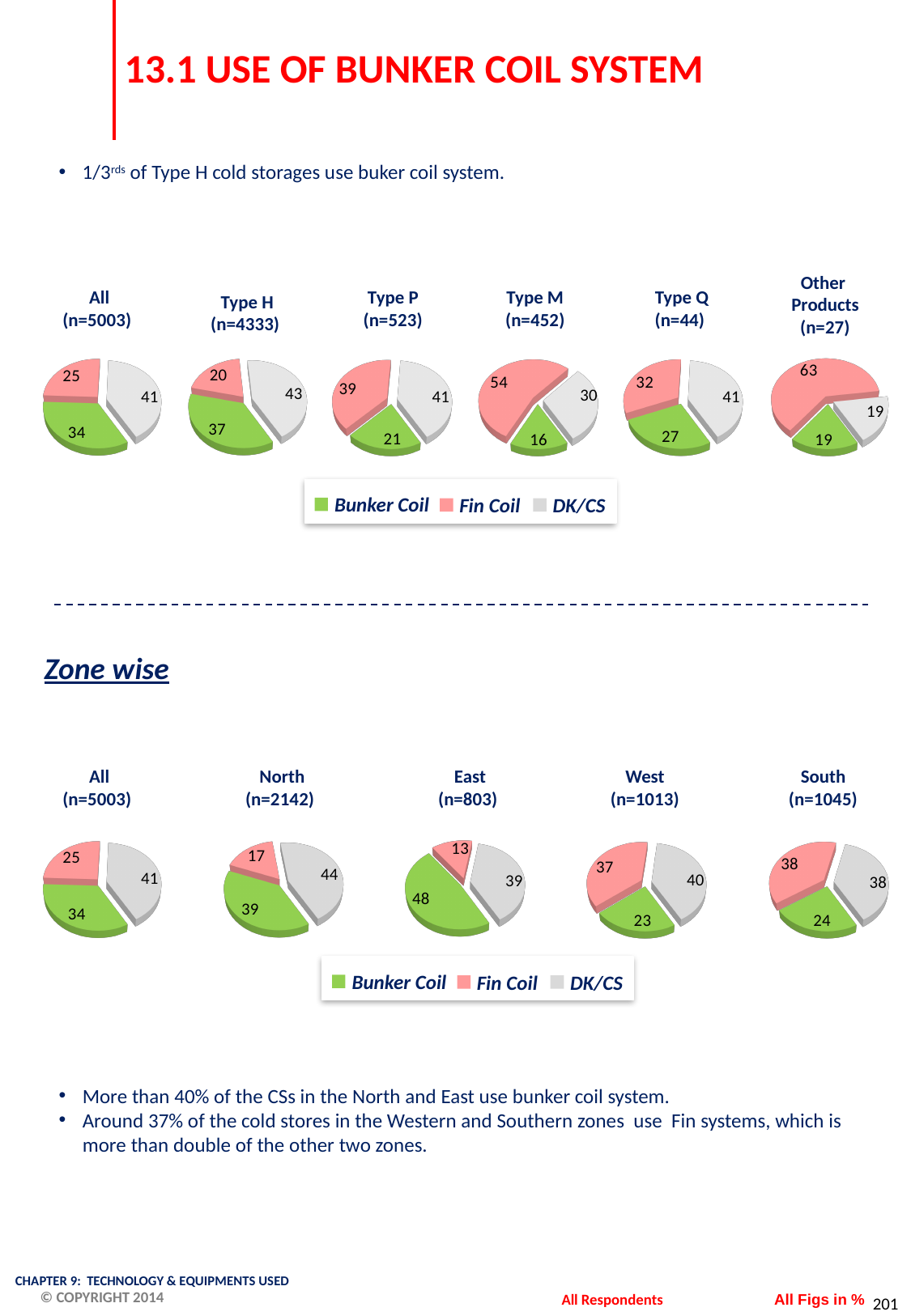
In the Other Products (n=27) pie chart, which category has the largest slice? Fin Coil How many series does the legend below the top row of pie charts list? 3 In the South (n=1045) pie chart, what share of the pie does Bunker Coil take? 24% In the East (n=803) pie chart, what is the value for Bunker Coil? 48 What kind of chart is used for the Type Q (n=44) data? Pie chart In the Type P (n=523) pie chart, what is the difference between the DK/CS value and the Bunker Coil value? 20 In the Type M (n=452) pie chart, what is the value for Fin Coil? 54 In the West (n=1013) pie chart, which is larger, Fin Coil or Bunker Coil? Fin Coil In the Type H (n=4333) pie chart, what is the value for Bunker Coil? 37 Which colour represents DK/CS in the legend? Grey In the North (n=2142) pie chart, which category has the smallest slice? Fin Coil How many pie charts are shown in the Zone wise section of the slide? 5